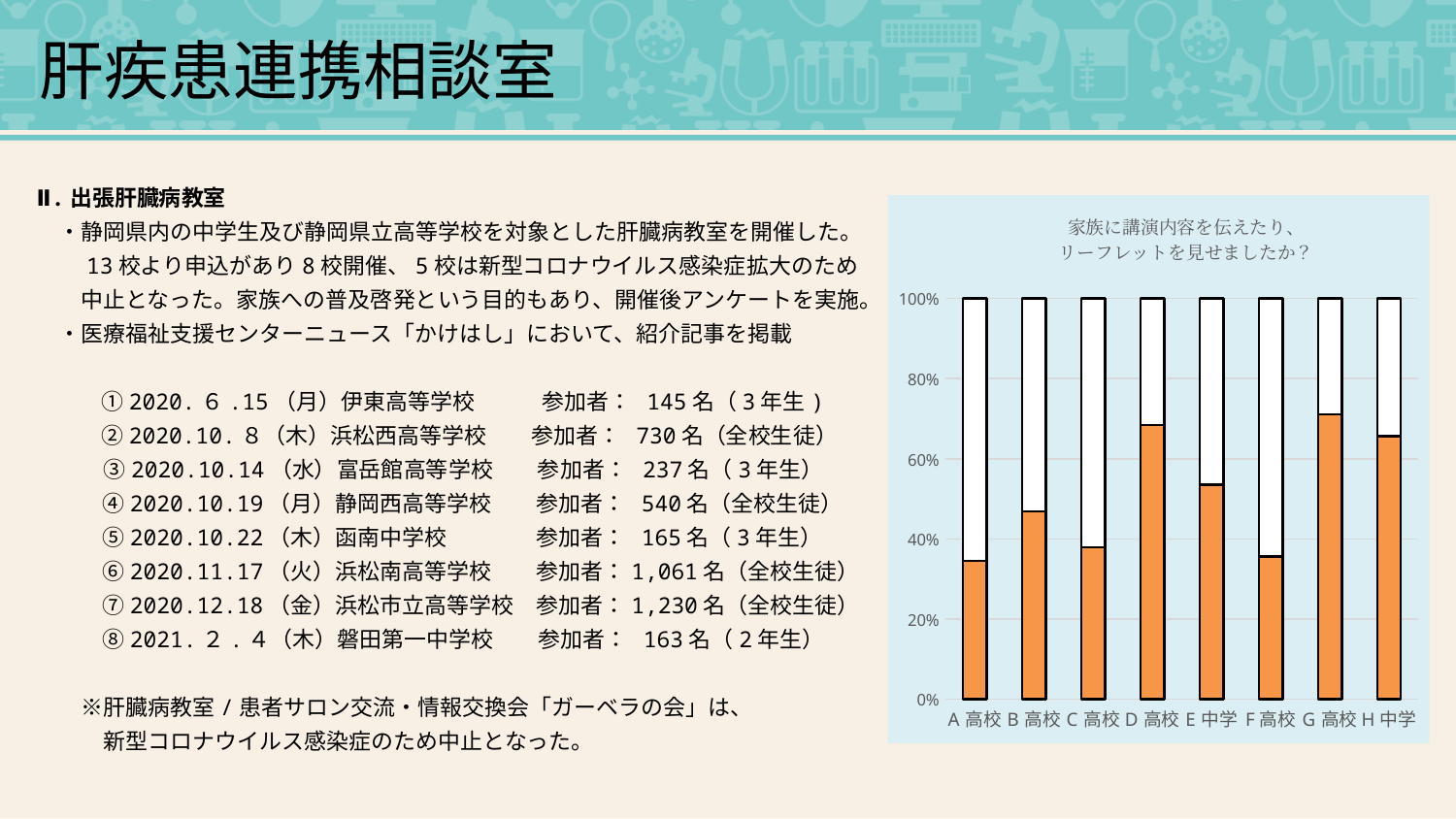
Is the orange portion for A 高校 greater or less than 40%? less Which has a larger orange portion, G 高校 or F 高校? G 高校 Is the orange portion for E 中学 greater or less than 40%? greater What is the total height of each stacked bar in the chart? 100% Is the orange portion for H 中学 greater or less than 60%? greater Which has a larger orange portion, D 高校 or A 高校? D 高校 How many schools (categories) are shown on the x axis of the chart? 8 What is the title of the chart? 家族に講演内容を伝えたり、リーフレットを見せましたか？ What kind of chart is shown on the slide? stacked bar chart